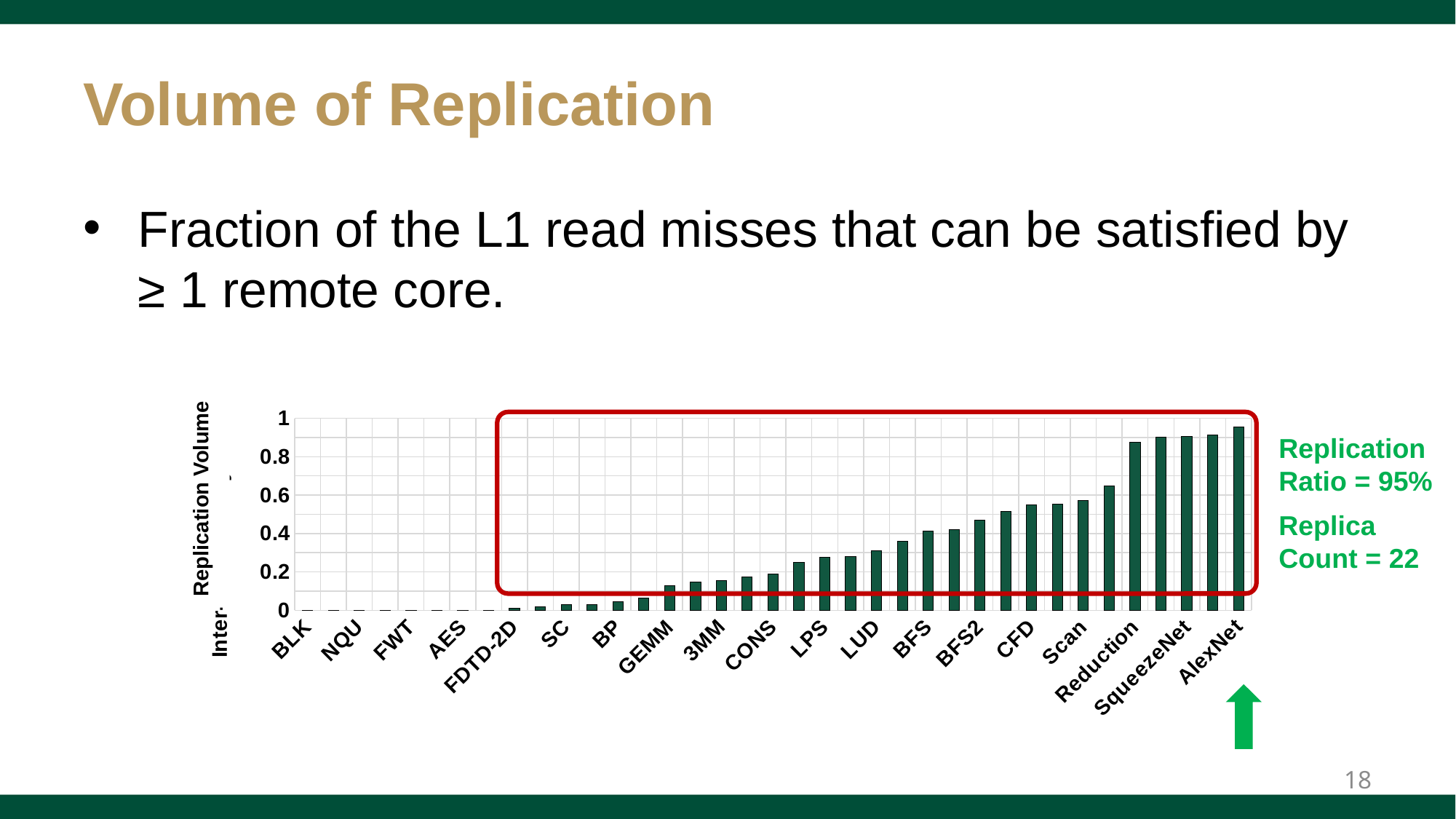
Is the Replication Volume for SqueezeNet greater or less than 0.8? greater Do the Replication Volume values rise or fall from left to right along the x axis? rise Which has a larger Replication Volume, AlexNet or BLK? AlexNet Is the Replication Volume for AlexNet greater or less than 0.8? greater Which category has the highest Replication Volume? AlexNet Is the Replication Volume for CFD greater or less than 0.2? greater Which has a larger Replication Volume, CFD or AlexNet? AlexNet What is the label of the y axis of the chart? Replication Volume What kind of chart is shown on the slide? bar chart What Replication Ratio is annotated next to the chart? 95%